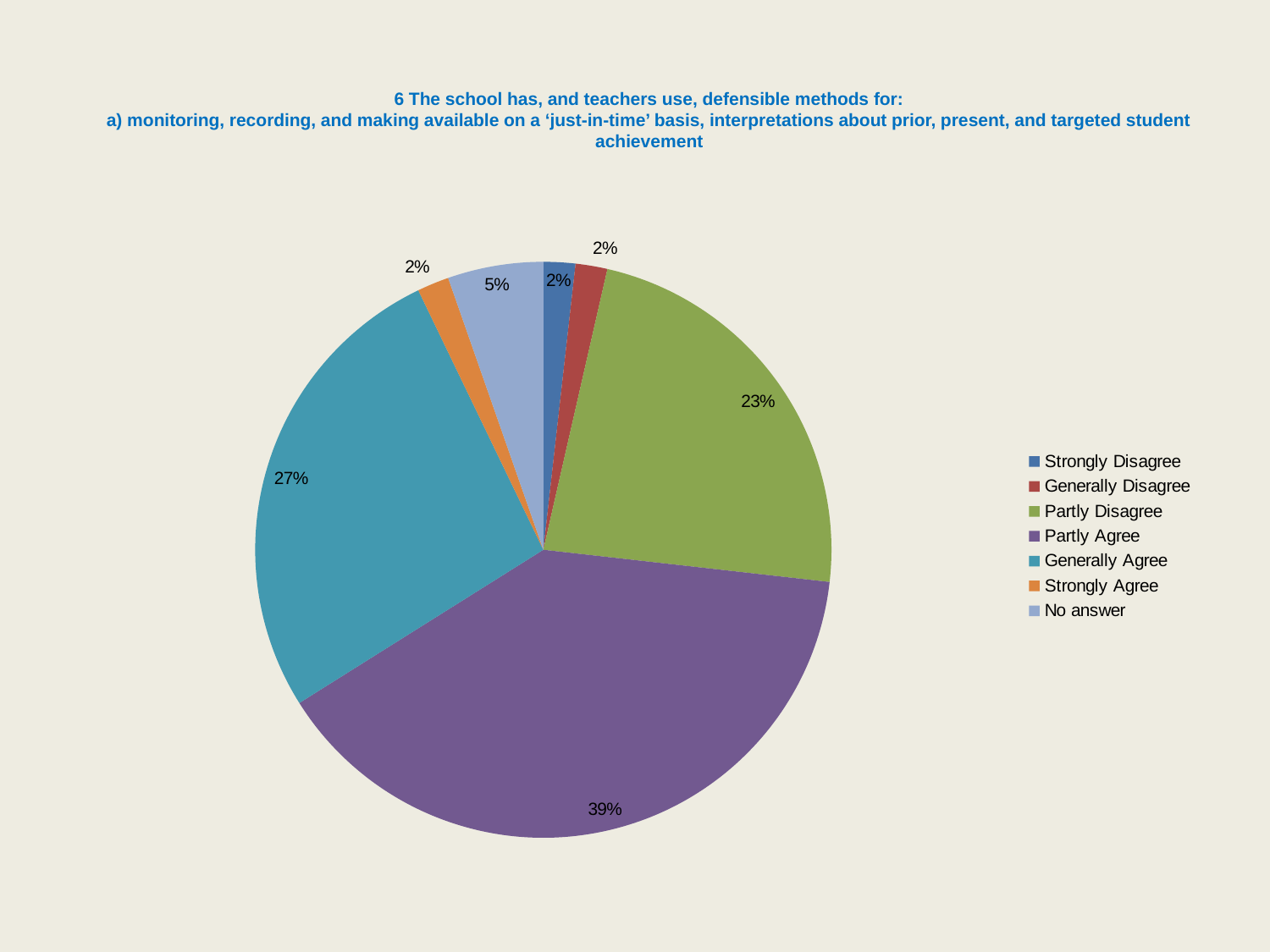
What is the combined share of Partly Disagree and Partly Agree? 62% What percentage of responses are No answer? 5% Which is larger, the share for Partly Disagree or the share for Generally Agree? Generally Agree Which response category has the largest share of the pie? Partly Agree How many categories does the legend list? 7 What percentage of responses are Partly Agree? 39% What type of chart is shown on the slide? pie chart What percentage of responses are Generally Agree? 27% What colour is the Partly Agree slice? purple What is the difference in percentage points between Partly Agree and Generally Agree? 12 What percentage of responses are Strongly Agree? 2% What percentage of responses are Partly Disagree? 23%